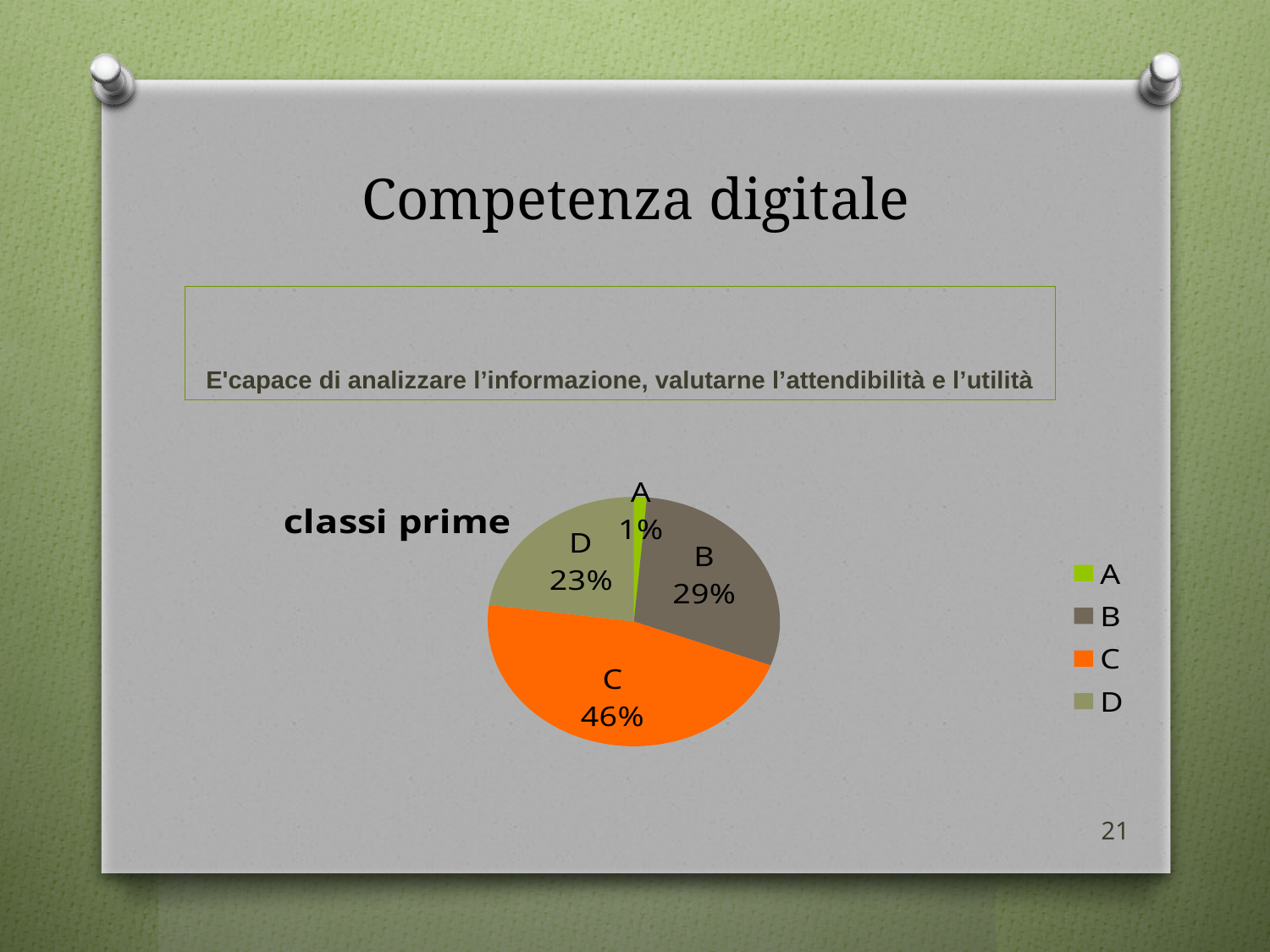
What percentage does slice D represent? 23% What percentage does slice C represent? 46% Which category has the largest share of the pie? C What colour is the slice for category C? orange Which is larger, the share for B or the share for D? B What type of chart is shown on the slide? pie chart Which category has the smallest share of the pie? A What is the difference in percentage points between C and B? 17 What is the title of the chart? classi prime What percentage does slice A represent? 1% How many categories does the legend list? 4 What percentage does slice B represent? 29%